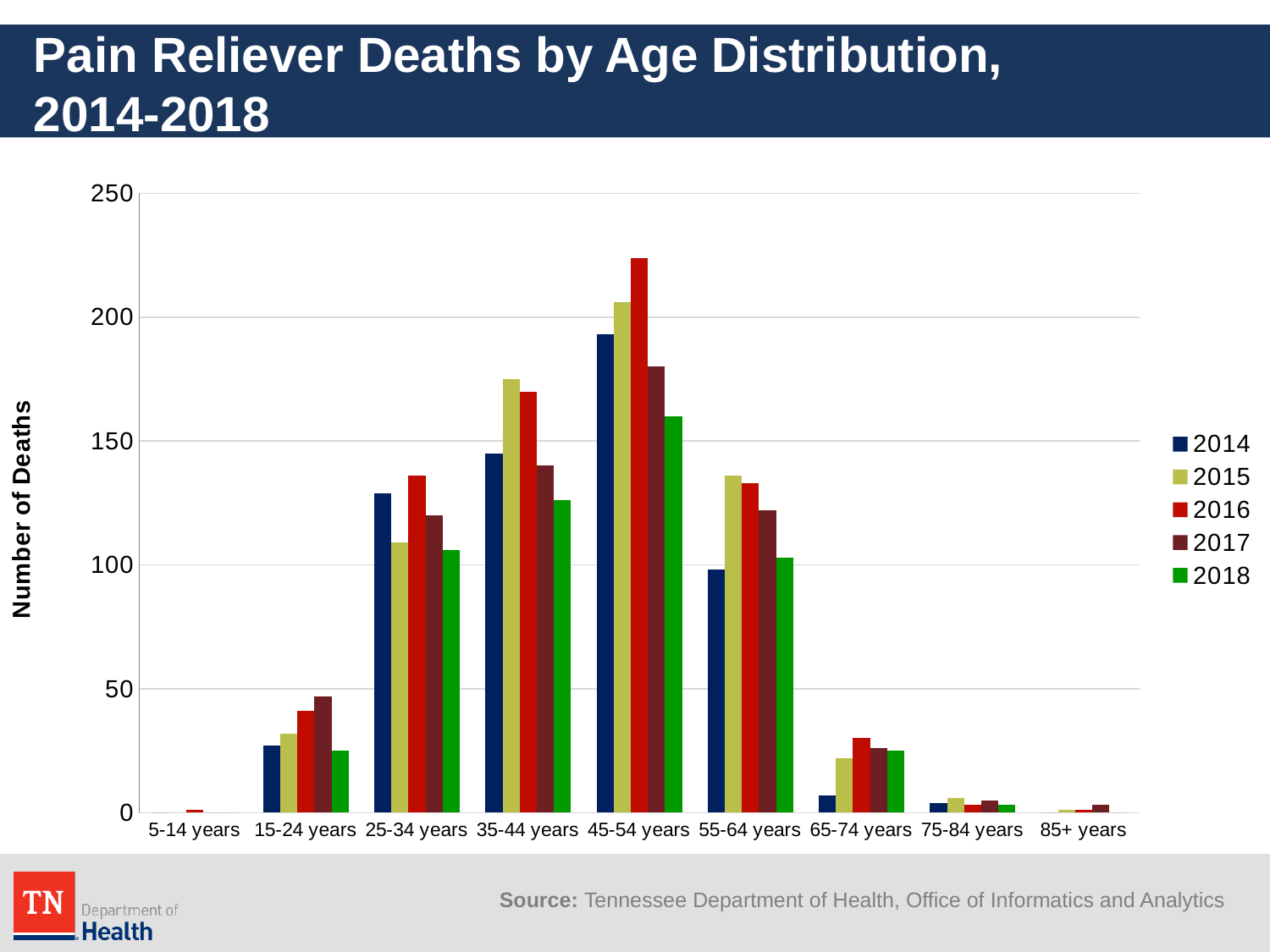
Is the 2018 value for 45-54 years greater or less than 150? greater How many series does the legend list? 5 For the 45-54 years group, which is larger, the 2015 value or the 2017 value? 2015 For the 45-54 years group, do the values rise or fall from 2016 to 2018? fall What kind of chart is shown on the slide? bar chart For the 35-44 years group, which is larger, the 2014 value or the 2015 value? 2015 Is the 2016 value for 45-54 years greater or less than 200? greater What is the title of the y axis? Number of Deaths How many age groups are shown on the x axis? 9 Is the 2014 value for 15-24 years greater or less than 50? less Which year has the lowest number of deaths for the 45-54 years group? 2018 Which age group has the highest number of deaths for 2016? 45-54 years